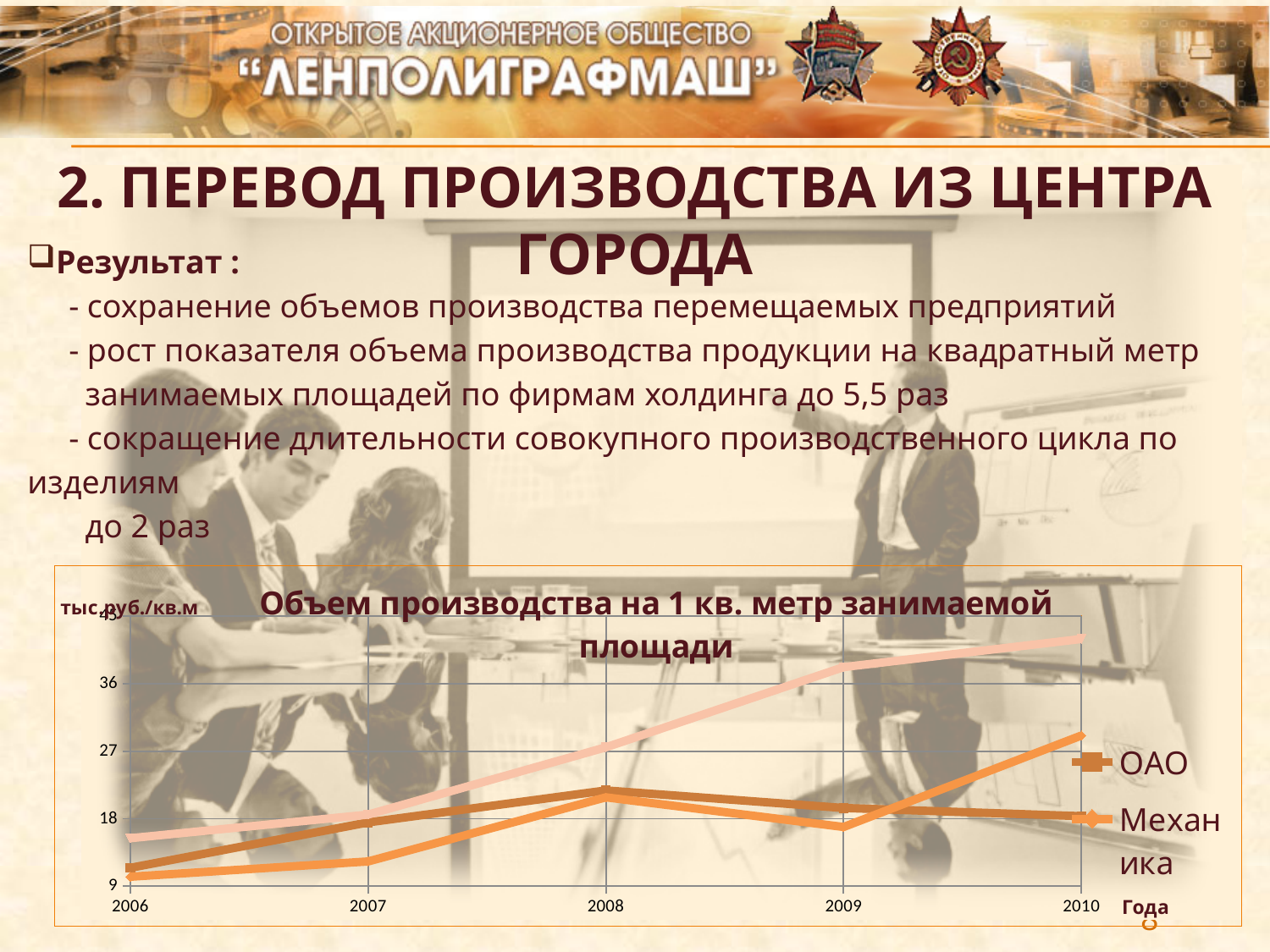
Is the value for Механика in 2010 greater or less than 27? greater Does the Механика series rise or fall from 2006 to 2010 overall? rise What kind of chart is shown on the slide? line chart In 2006, which series has the higher value, ОАО or Механика? ОАО What is the title of the chart? Объем производства на 1 кв. метр занимаемой площади Is the value for ОАО in 2006 greater or less than 18? less Is the value for Механика in 2007 greater or less than 18? less What unit is shown on the vertical axis of the chart? тыс.руб./кв.м How many years are plotted along the x axis of the chart? 5 In 2010, which series has the higher value, ОАО or Механика? Механика Does the ОАО series rise or fall from 2008 to 2010? fall